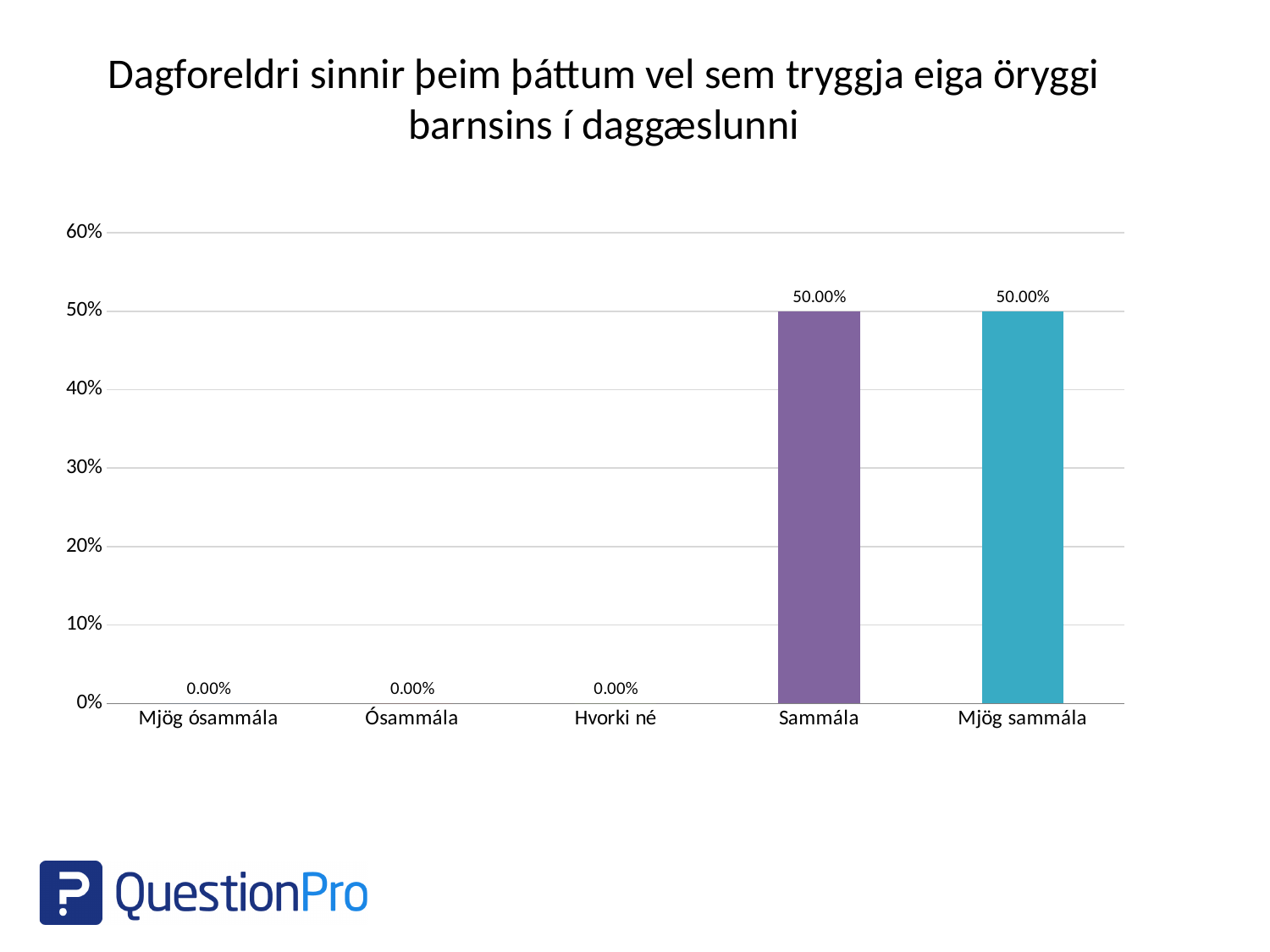
Which is larger, the value for Mjög sammála or the value for Ósammála? Mjög sammála What kind of chart is shown on the slide? Bar chart How many categories are shown on the x axis? 5 What is the value for Mjög sammála? 50.00% What is the value for Mjög ósammála? 0.00% What is the combined total of the values for Sammála and Mjög sammála? 100.00% What is the value for Ósammála? 0.00% What is the value for Hvorki né? 0.00% What is the highest value shown on the y axis? 60% Is the value for Sammála greater or less than 40%? greater What is the value for Sammála? 50.00% What is the difference between the values for Sammála and Hvorki né? 50.00%